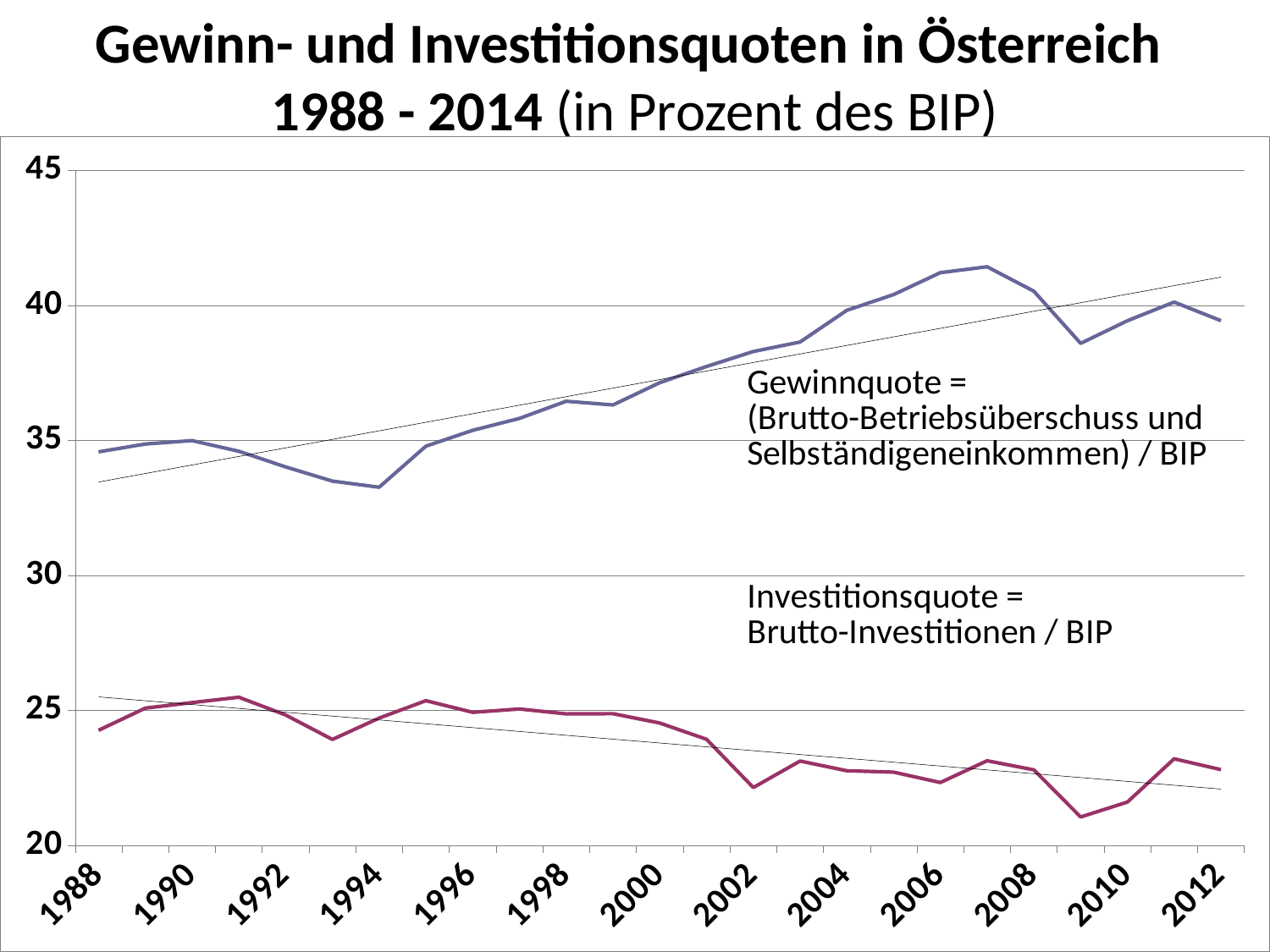
What is the title of the chart? Gewinn- und Investitionsquoten in Österreich 1988 - 2014 (in Prozent des BIP) Is the Investitionsquote value for 1990 greater or less than 25? greater Is the Gewinnquote value for 2006 greater or less than 40? greater Is the Gewinnquote value for 1994 greater or less than 35? less What kind of chart is shown on the slide? line chart In what unit are the values on the chart expressed? Prozent des BIP Does the Gewinnquote line rise or fall overall from 1988 to the end of the period? rise Does the Investitionsquote line rise or fall overall from 1988 to the end of the period? fall Which is higher in 2004, the Gewinnquote or the Investitionsquote? Gewinnquote